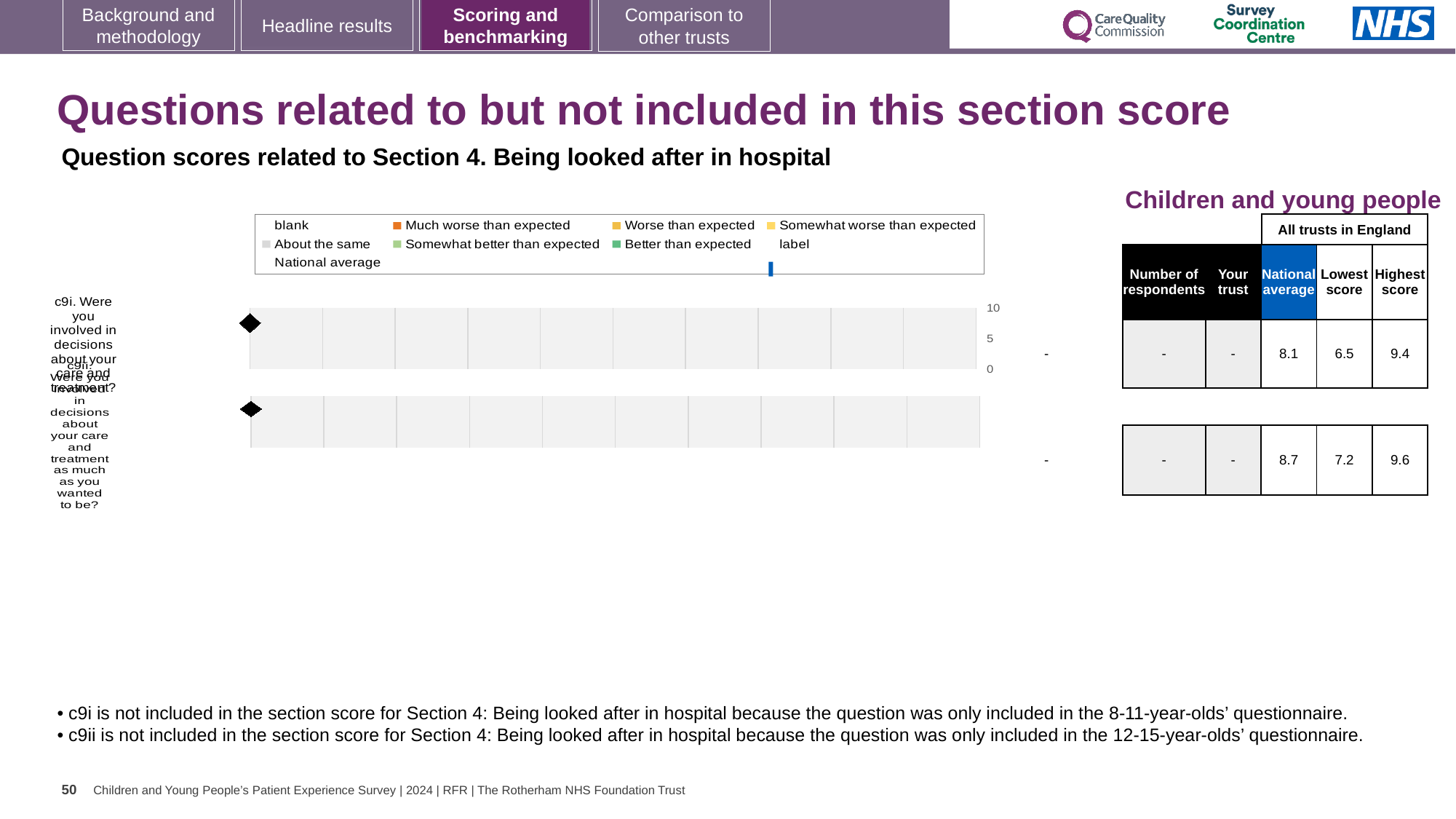
What kind of chart is shown on the slide? bar chart What is the difference between the highest and lowest scores for c9i? 2.9 In the table next to the chart, what is the lowest score across all trusts in England for c9i? 6.5 What is the maximum value shown on the chart's numeric axis? 10 In the table next to the chart, what is the national average score for c9i? 8.1 Is the national average for c9i greater or less than 5? greater Which question has the higher national average, c9i or c9ii? c9ii How many questions (categories) are listed on the chart's vertical axis? 2 In the table next to the chart, what is the highest score across all trusts in England for c9ii? 9.6 What is the difference between the national averages of c9ii and c9i? 0.6 In the table next to the chart, what is the national average score for c9ii? 8.7